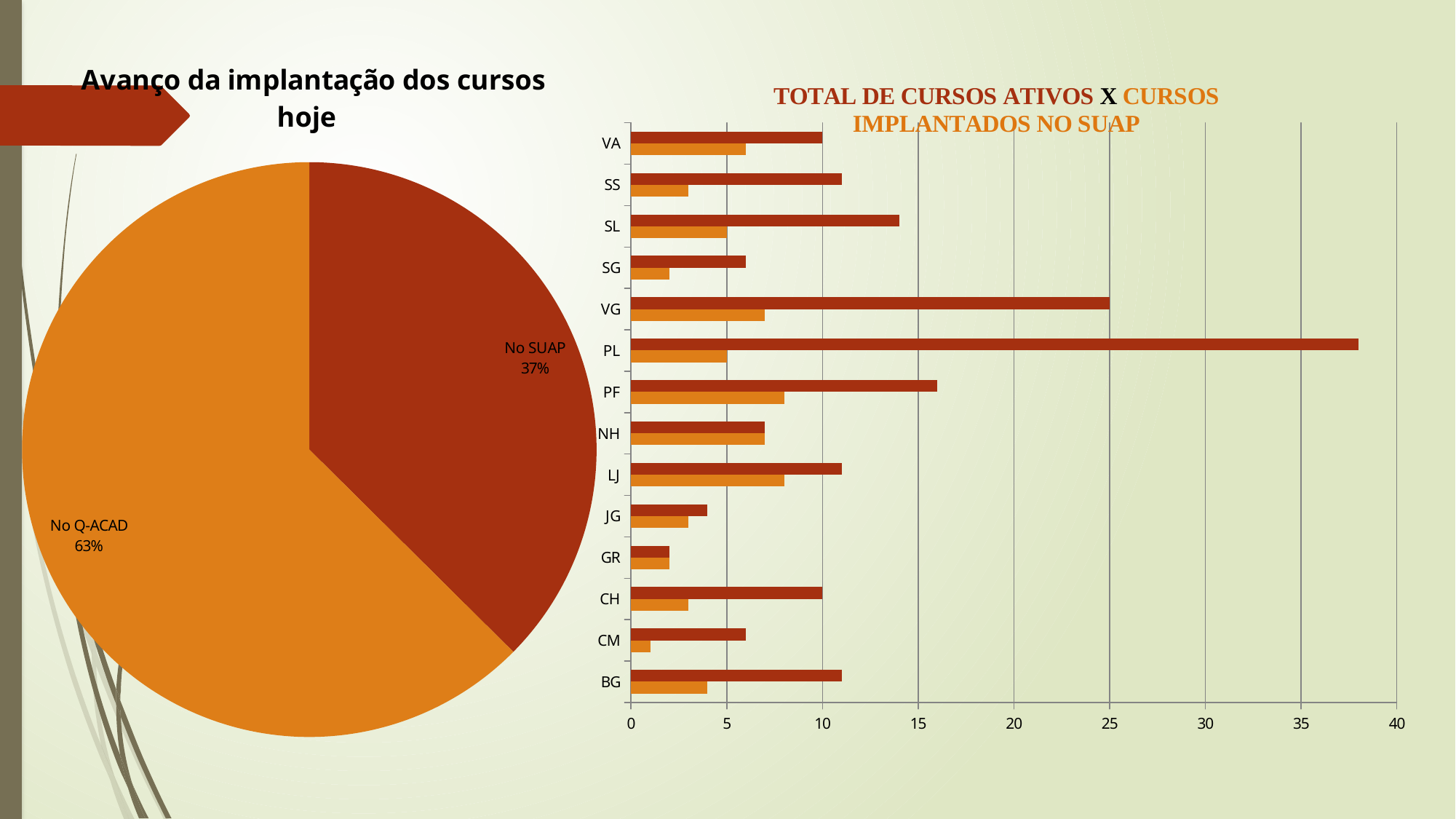
In the chart 'TOTAL DE CURSOS ATIVOS X CURSOS IMPLANTADOS NO SUAP', is the dark red bar for SL greater or less than 10? greater In the pie chart 'Avanço da implantação dos cursos hoje', which slice is larger? No Q-ACAD What kind of chart is the chart titled 'Avanço da implantação dos cursos hoje'? pie chart In the pie chart 'Avanço da implantação dos cursos hoje', what share is labelled 'No SUAP'? 37% How many slices does the pie chart 'Avanço da implantação dos cursos hoje' have? 2 In the chart 'TOTAL DE CURSOS ATIVOS X CURSOS IMPLANTADOS NO SUAP', is the dark red bar for PL greater or less than 35? greater In the pie chart 'Avanço da implantação dos cursos hoje', what share is labelled 'No Q-ACAD'? 63% In the chart 'TOTAL DE CURSOS ATIVOS X CURSOS IMPLANTADOS NO SUAP', is the dark red bar for GR greater or less than 5? less How many categories are shown on the vertical axis of the chart 'TOTAL DE CURSOS ATIVOS X CURSOS IMPLANTADOS NO SUAP'? 14 In the chart 'TOTAL DE CURSOS ATIVOS X CURSOS IMPLANTADOS NO SUAP', which category has the longest dark red bar? PL What kind of chart is the chart titled 'TOTAL DE CURSOS ATIVOS X CURSOS IMPLANTADOS NO SUAP'? bar chart In the chart 'TOTAL DE CURSOS ATIVOS X CURSOS IMPLANTADOS NO SUAP', which has the longer dark red bar, VG or PF? VG